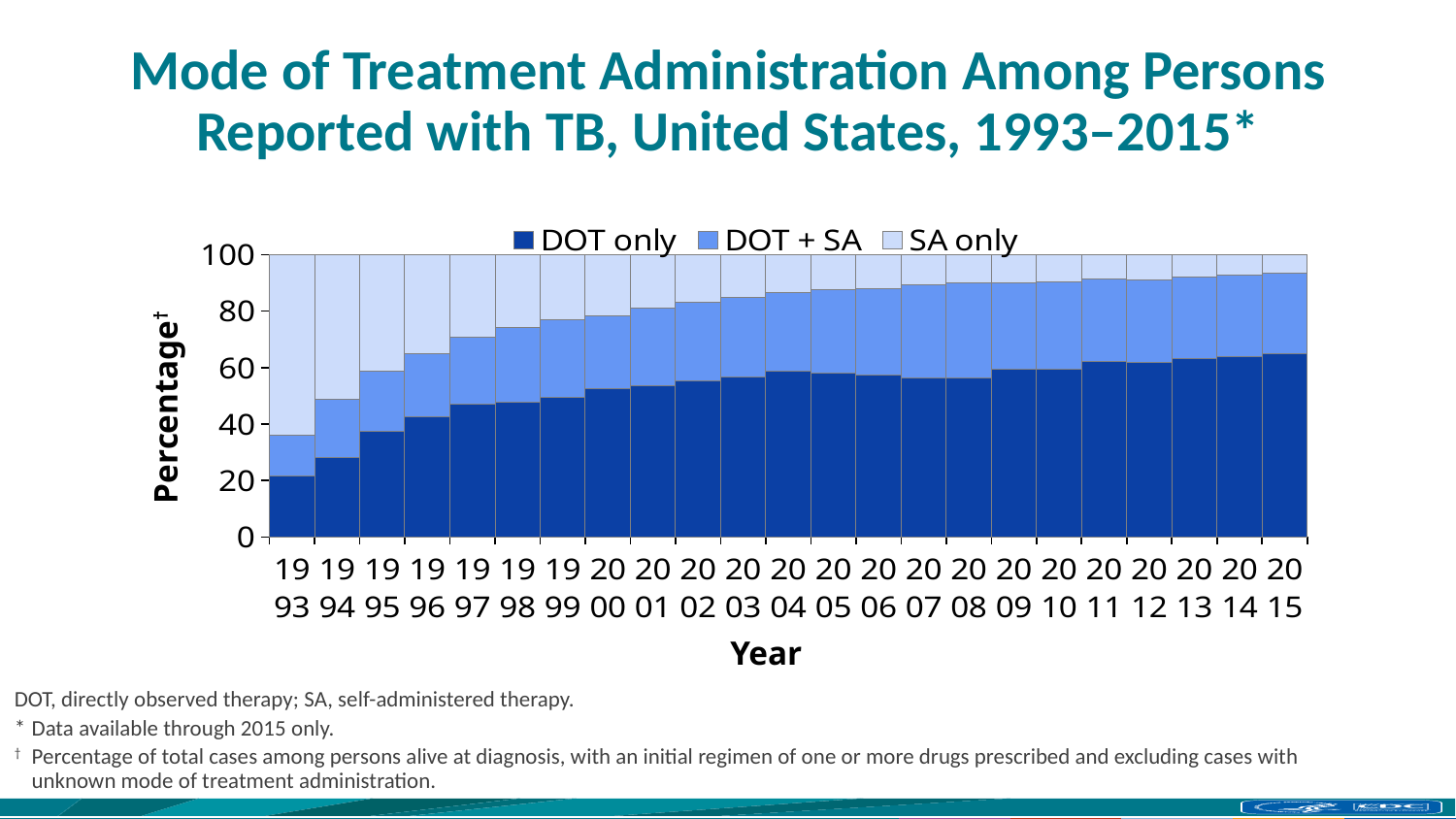
Which year has the lowest value for DOT only? 1993 Which is larger in 1993, the DOT only share or the SA only share? SA only Is the value for DOT only in 2000 greater or less than 40? greater Does the SA only share rise or fall from 1993 to 2015? fall Does the DOT only share rise or fall from 1993 to 2015? rise What kind of chart is shown on the slide? stacked bar chart How many years are shown along the x axis? 23 How many series does the legend list? 3 What is the label of the y axis? Percentage Is the value for DOT only in 2015 greater or less than 60? greater Is the value for DOT only in 1993 greater or less than 40? less